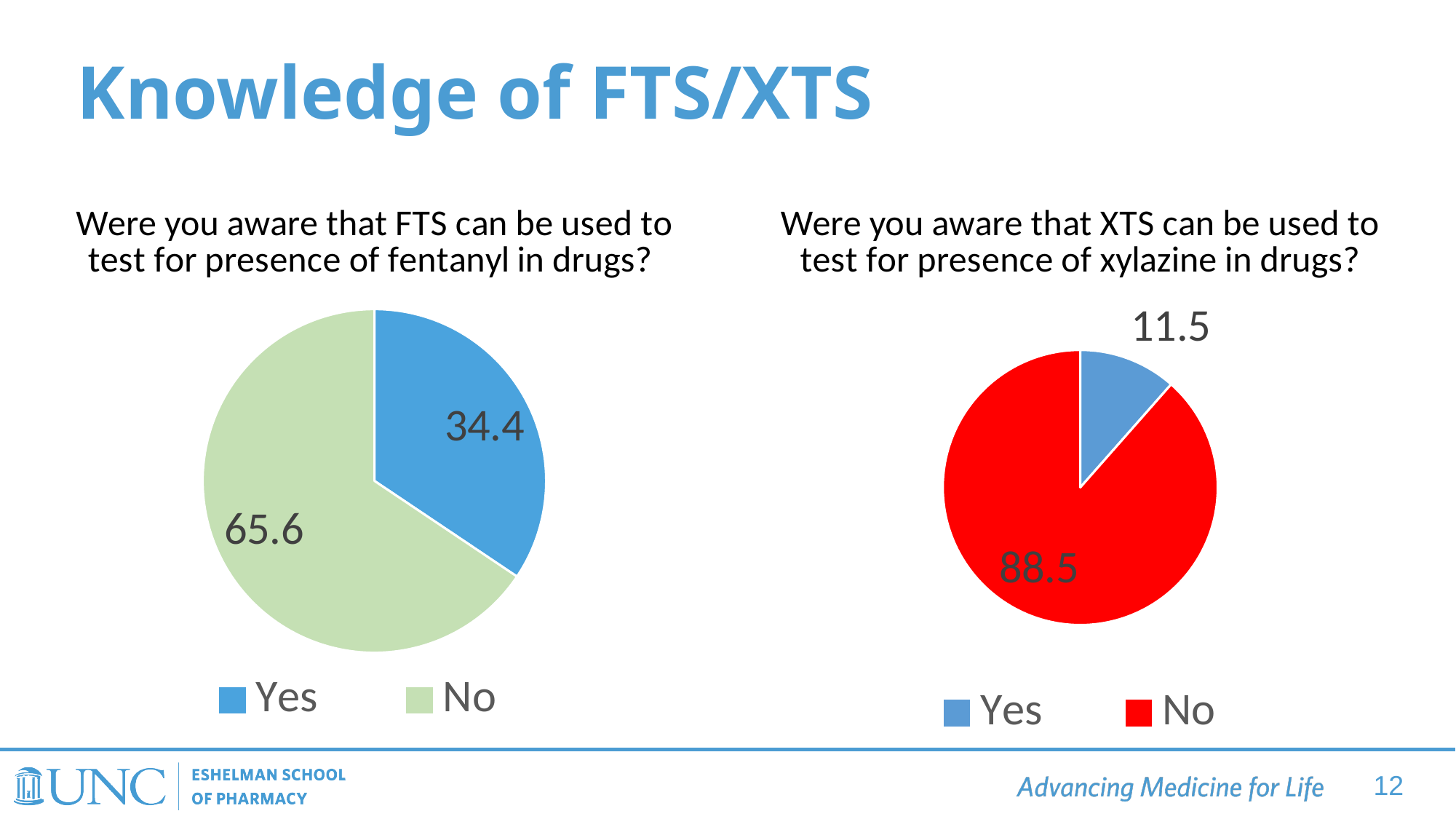
In the left pie chart (FTS), what is the difference between the No and Yes values? 31.2 Is the Yes value larger in the left pie chart (FTS) or the right pie chart (XTS)? Left (FTS) In the right pie chart (XTS), what is the value for No? 88.5 In the left pie chart (FTS), which slice is the largest? No In the left pie chart (FTS), what is the value for No? 65.6 In the right pie chart (XTS), what colour is the No slice? Red In the left pie chart (FTS), what is the value for Yes? 34.4 In the right pie chart (XTS), what is the difference between the No and Yes values? 77.0 How many slices does the right pie chart (XTS) have? 2 In the right pie chart (XTS), what is the value for Yes? 11.5 In the right pie chart (XTS), which slice is the smallest? Yes What kind of chart is the left chart (FTS)? Pie chart